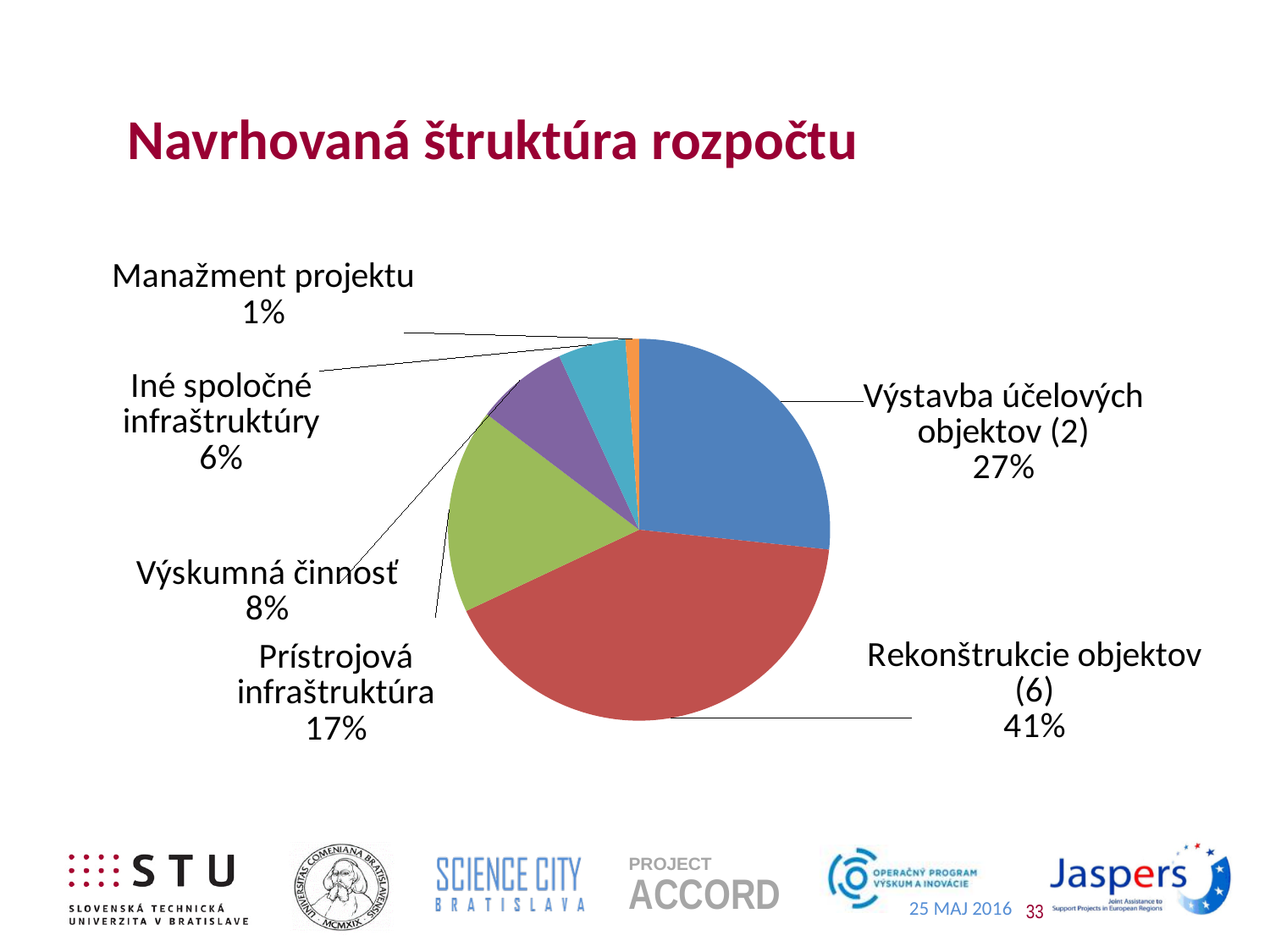
Which category has the smallest share of the budget? Manažment projektu How many categories are shown in the pie chart? 6 What kind of chart is shown on the slide? pie chart What share of the budget is allocated to Manažment projektu? 1% What share of the budget is allocated to Rekonštrukcie objektov (6)? 41% What is the title of the slide containing the chart? Navrhovaná štruktúra rozpočtu What share of the budget is allocated to Výskumná činnosť? 8% Which has a larger share: Iné spoločné infraštruktúry or Výskumná činnosť? Výskumná činnosť Which category has the largest share of the budget? Rekonštrukcie objektov (6) What is the difference in percentage points between Rekonštrukcie objektov (6) and Výstavba účelových objektov (2)? 14